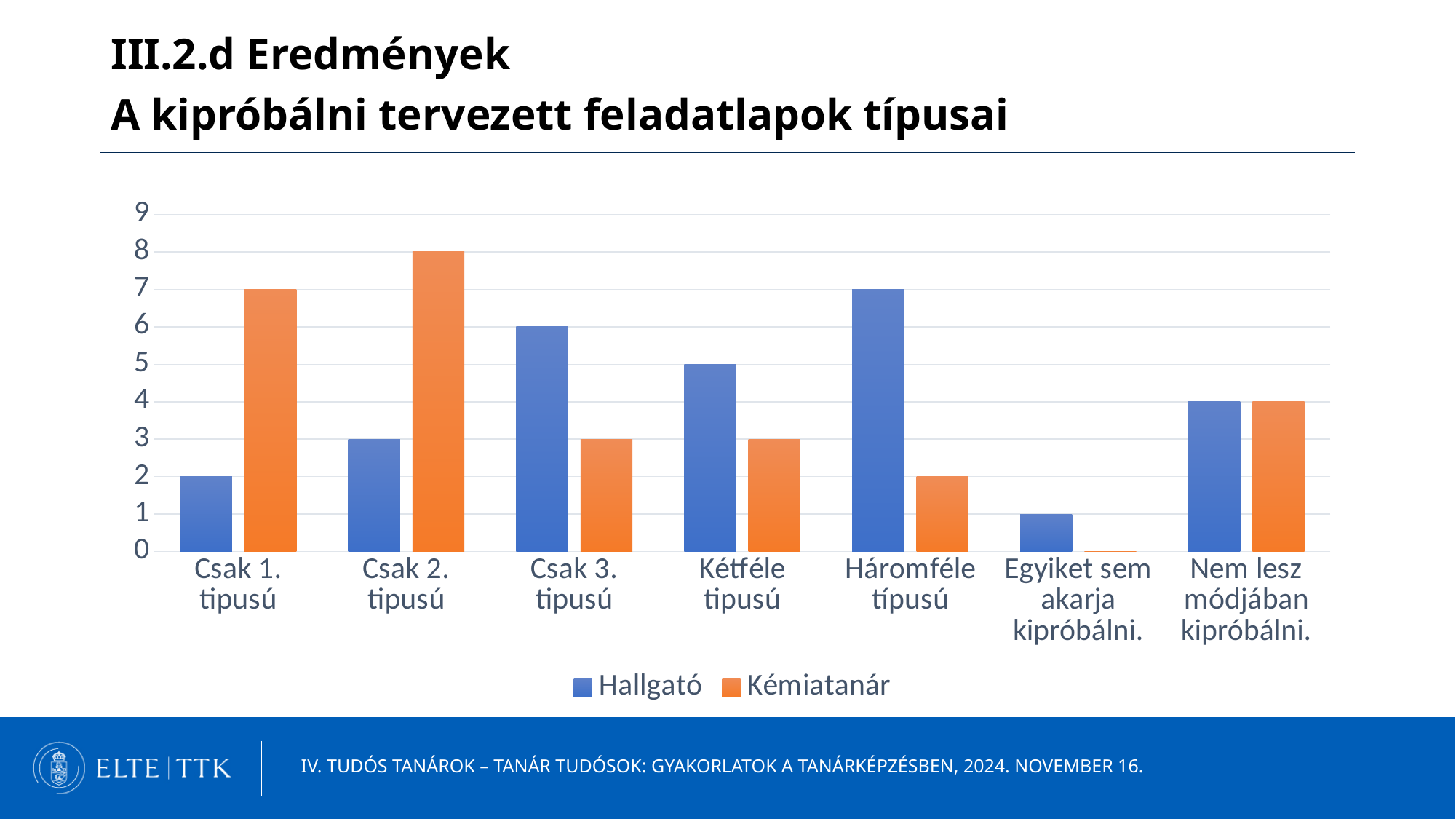
For Kétféle típusú, which series has the larger value, Hallgató or Kémiatanár? Hallgató How many series does the legend list? 2 Which category has the lowest Hallgató value? Egyiket sem akarja kipróbálni. Which category has the highest Kémiatanár value? Csak 2. típusú Which colour represents the Kémiatanár series? orange What kind of chart is shown on the slide? bar chart What is the Hallgató value for Csak 3. típusú? 6 What is the Hallgató value for Háromféle típusú? 7 How many categories are shown on the x axis? 7 Is the Hallgató value for Csak 2. típusú greater or less than 5? less What is the Kémiatanár value for Csak 2. típusú? 8 What is the difference between the Kémiatanár and Hallgató values for Csak 1. típusú? 5